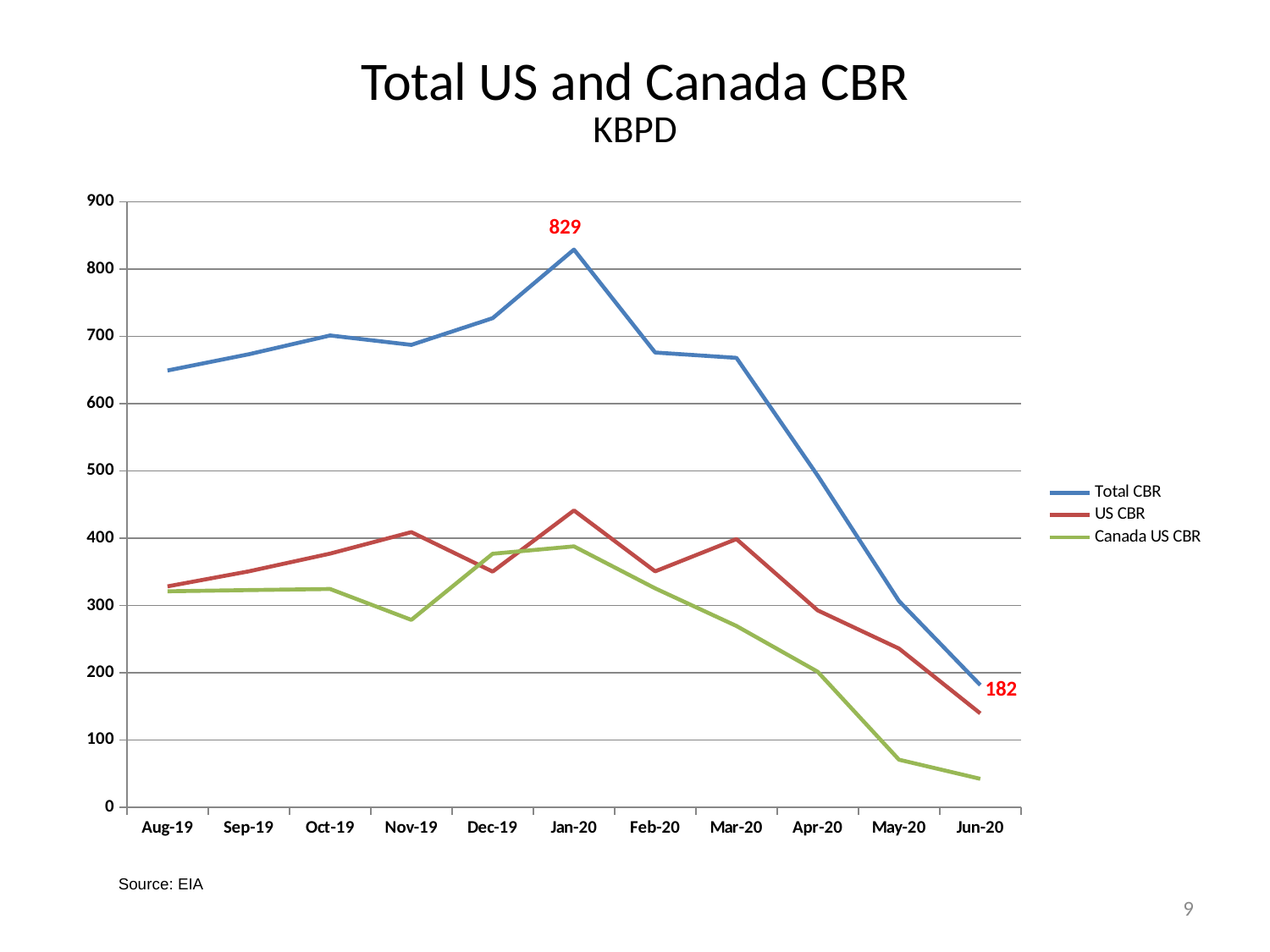
How many series does the legend list? 3 What is the difference between the Total CBR values in Jan-20 and Jun-20? 647 Does Total CBR rise or fall from Jan-20 to Jun-20? fall Is the value for US CBR in Jan-20 greater or less than 400? greater Is the value for Canada US CBR in May-20 greater or less than 100? less What kind of chart is shown on the slide? line chart In which month is Total CBR highest? Jan-20 What is the value of Total CBR in Jan-20? 829 In which month is Total CBR lowest? Jun-20 In Nov-19, which is larger: US CBR or Canada US CBR? US CBR What is the value of Total CBR in Jun-20? 182 How many months are plotted along the x axis? 11